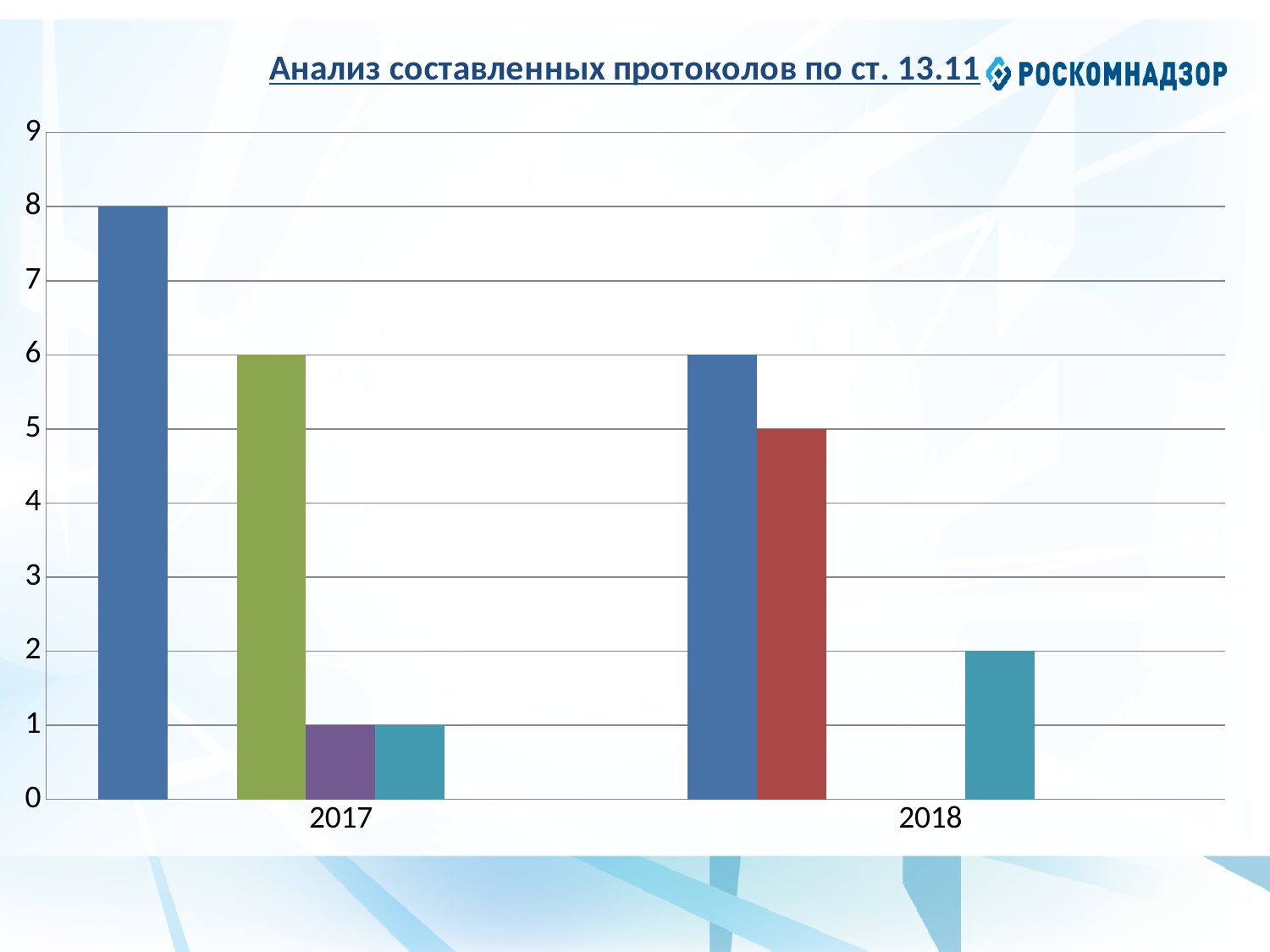
Which bar is the highest on the chart? the blue bar for 2017 How many categories are shown on the x axis? 2 What is the value of the blue bar for 2017? 8 What is the value of the green bar for 2017? 6 What is the value of the red bar for 2018? 5 What is the value of the teal bar for 2018? 2 What kind of chart is shown on the slide? bar chart What is the difference between the blue bar for 2017 and the blue bar for 2018? 2 What is the title of the chart? Анализ составленных протоколов по ст. 13.11 What is the difference between the teal bar for 2018 and the teal bar for 2017? 1 Which is larger, the green bar for 2017 or the red bar for 2018? the green bar for 2017 Does the blue bar rise or fall from 2017 to 2018? fall